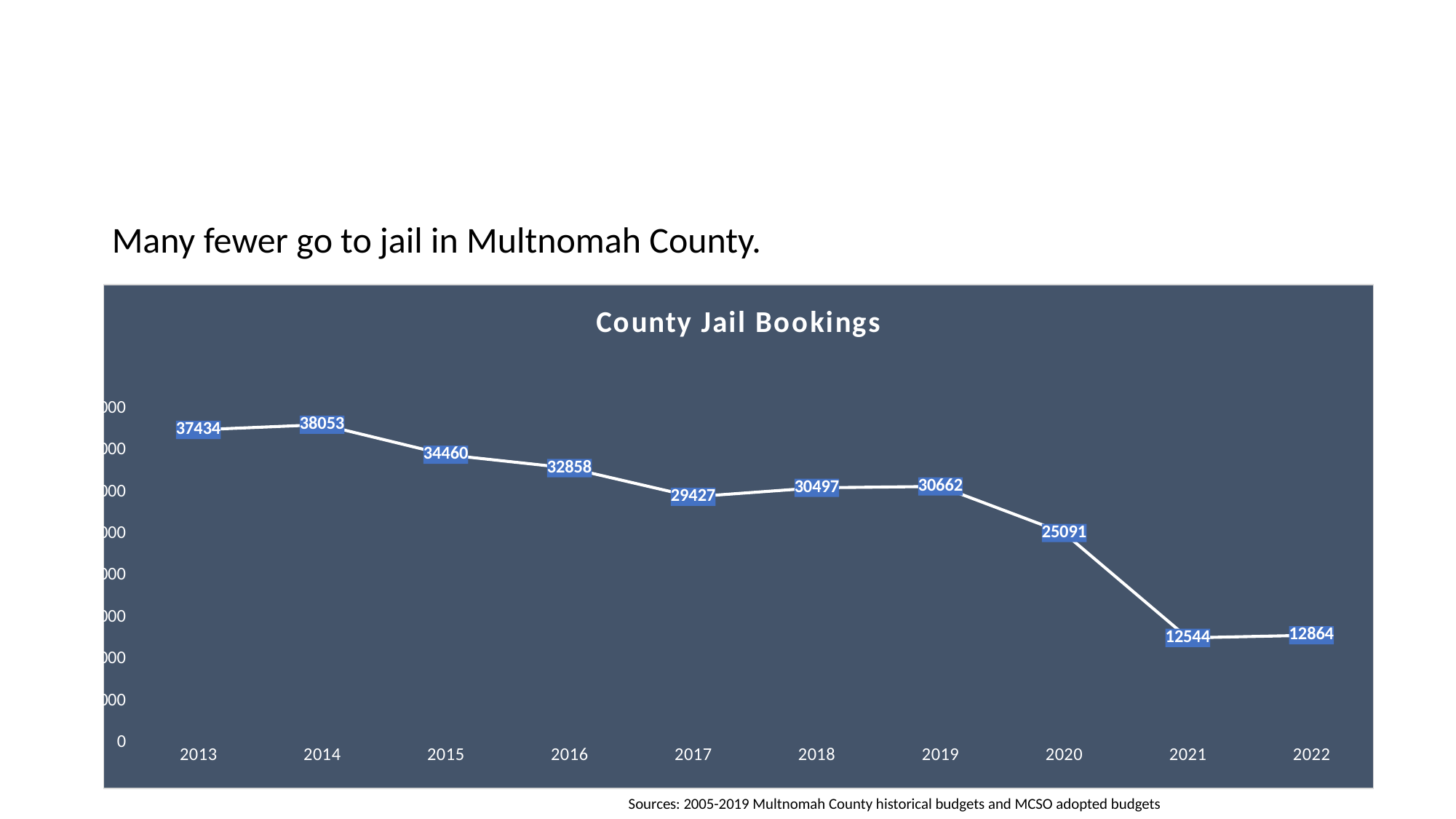
How many years are plotted in the County Jail Bookings chart? 10 What is the difference between the 2020 and 2021 values in the County Jail Bookings chart? 12547 What kind of chart is the County Jail Bookings chart? line chart Which year has the highest value in the County Jail Bookings chart? 2014 What is the value for 2017 in the County Jail Bookings chart? 29427 What is the difference between the 2014 and 2013 values in the County Jail Bookings chart? 619 What is the value for 2013 in the County Jail Bookings chart? 37434 What is the value for 2020 in the County Jail Bookings chart? 25091 What is the title of the chart on the slide? County Jail Bookings Which is larger in the County Jail Bookings chart, the value for 2018 or the value for 2016? 2016 Which year has the lowest value in the County Jail Bookings chart? 2021 Do the values in the County Jail Bookings chart generally rise or fall from 2013 to 2022? fall